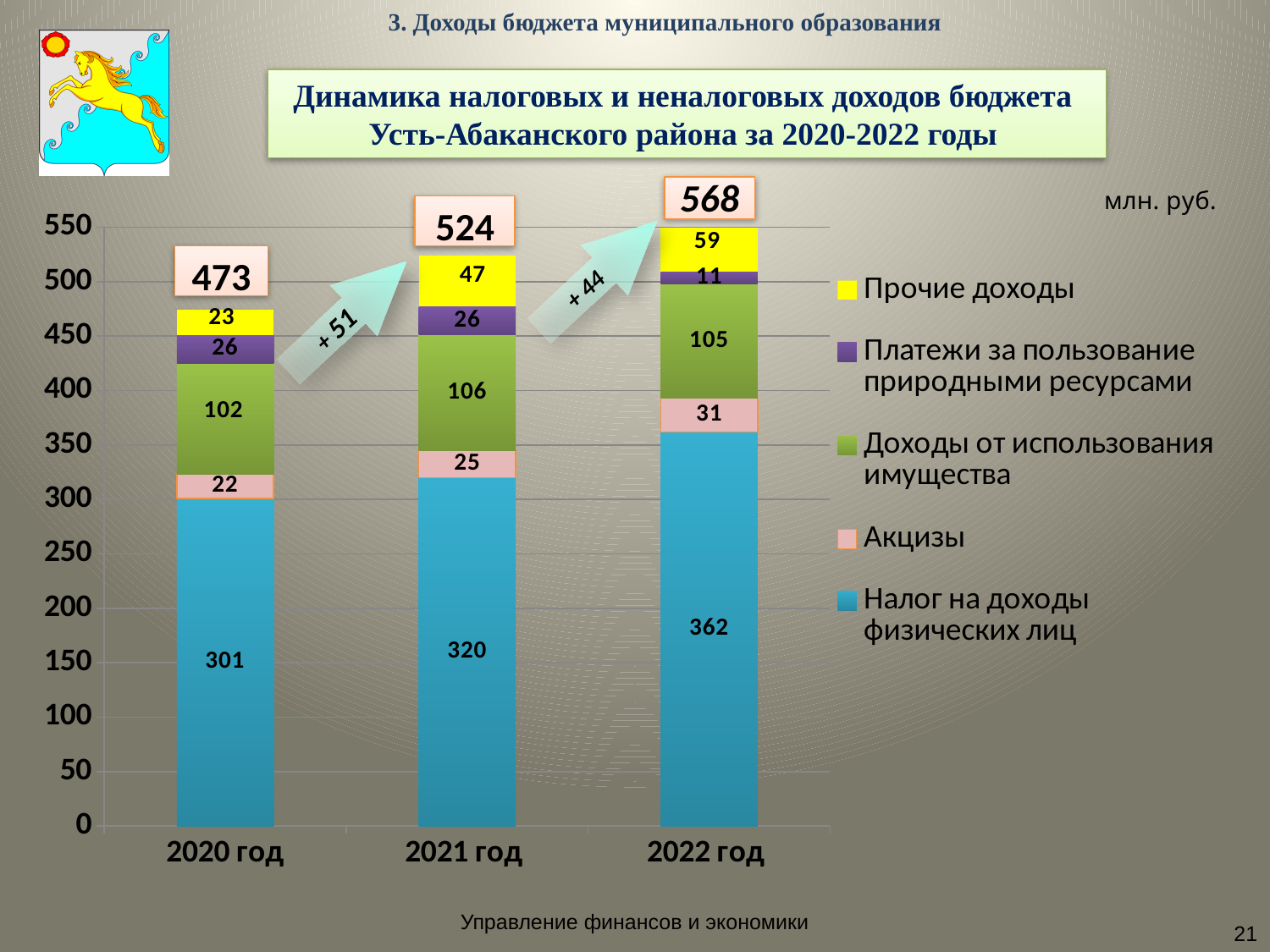
What is the difference between the totals for 2021 год and 2020 год? 51 What is the value of Налог на доходы физических лиц for 2021 год? 320 Do the total values rise or fall from 2020 год to 2022 год? rise How many series does the legend list? 5 How many years (categories) are shown on the x axis? 3 Which is larger: Платежи за пользование природными ресурсами in 2020 год or in 2022 год? 2020 год What is the value of Прочие доходы for 2022 год? 59 What is the value of Акцизы for 2022 год? 31 What is the total of the stacked bar for 2022 год? 568 What is the value of Доходы от использования имущества for 2020 год? 102 What kind of chart is shown on the slide? stacked bar chart Which year has the highest total? 2022 год